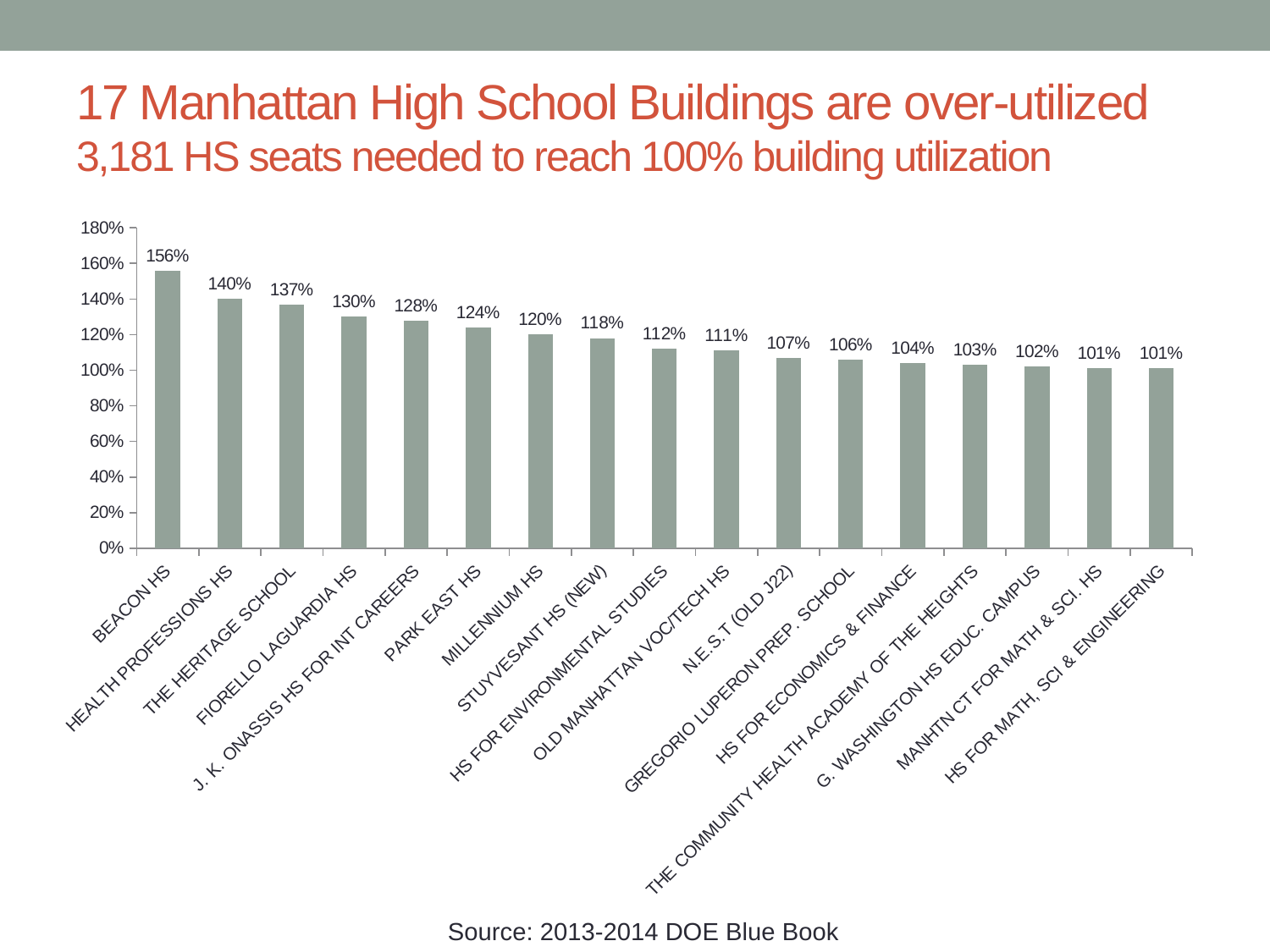
What is the difference in utilization between BEACON HS and MILLENNIUM HS? 36% What is the building utilization for G. WASHINGTON HS EDUC. CAMPUS? 102% Which has a higher utilization, FIORELLO LAGUARDIA HS or HS FOR ENVIRONMENTAL STUDIES? FIORELLO LAGUARDIA HS What kind of chart is shown on the slide? Bar chart Do the values rise or fall from left to right along the x axis? Fall What is the building utilization for PARK EAST HS? 124% What is the difference in utilization between HEALTH PROFESSIONS HS and THE HERITAGE SCHOOL? 3% What is the building utilization for STUYVESANT HS (NEW)? 118% Is the value for N.E.S.T (OLD J22) greater or less than 120%? less Which school building has the highest utilization? BEACON HS What is the building utilization for BEACON HS? 156% How many school buildings are shown in the chart? 17